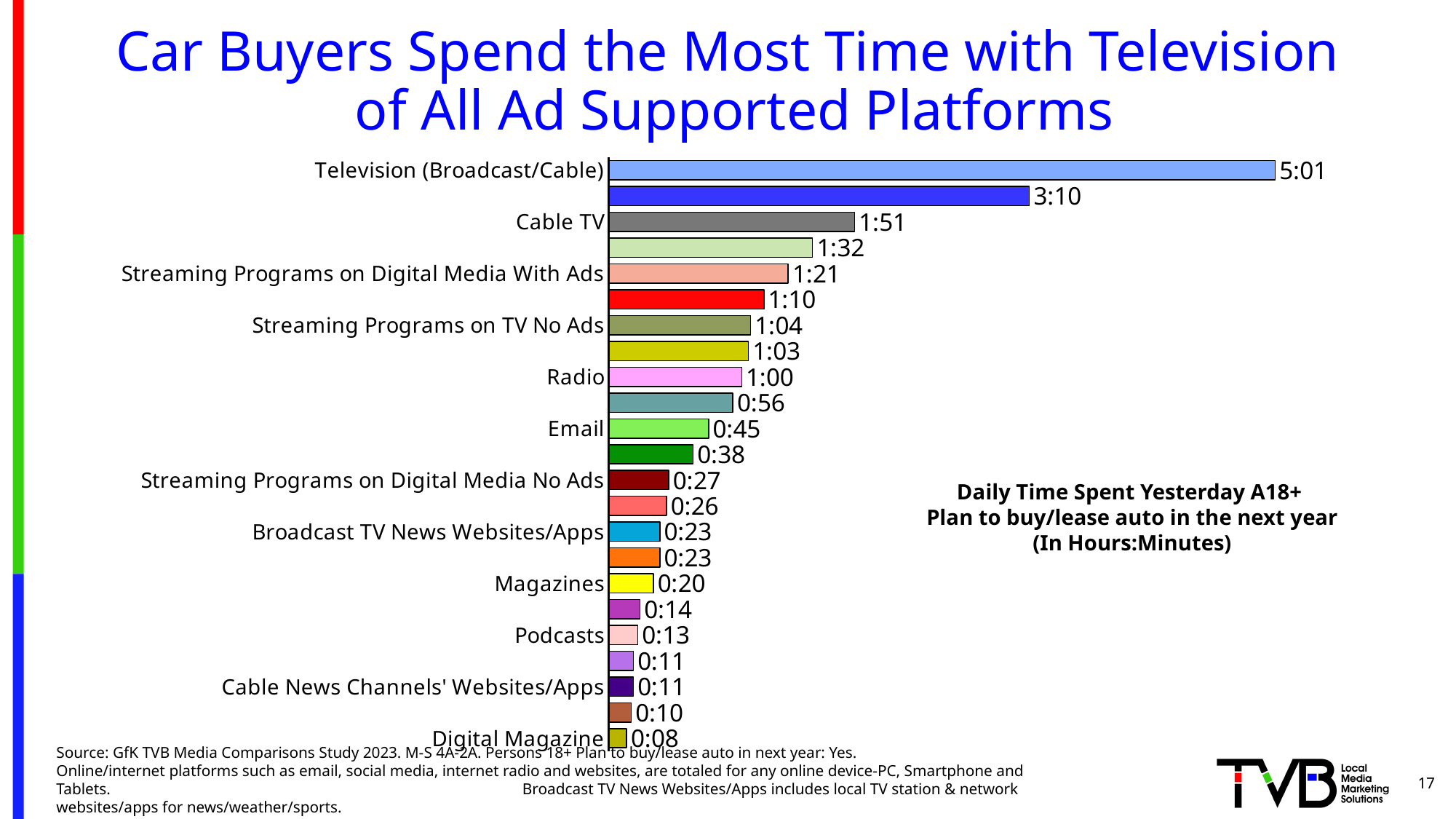
What kind of chart is shown on the slide? Bar chart Which category has the highest value on the chart? Television (Broadcast/Cable) What is the value shown for Podcasts? 0:13 What is the value shown for Radio? 1:00 Which category has the lowest value on the chart? Digital Magazine What is the value shown for Email? 0:45 What is the value shown for Cable TV? 1:51 Which has a larger value, Magazines or Podcasts? Magazines How many bars are plotted on the chart? 23 What is the difference between the values for Radio and Email? 0:15 How much more time is spent with Television (Broadcast/Cable) than with Cable TV? 3:10 What is the daily time spent with Television (Broadcast/Cable)? 5:01